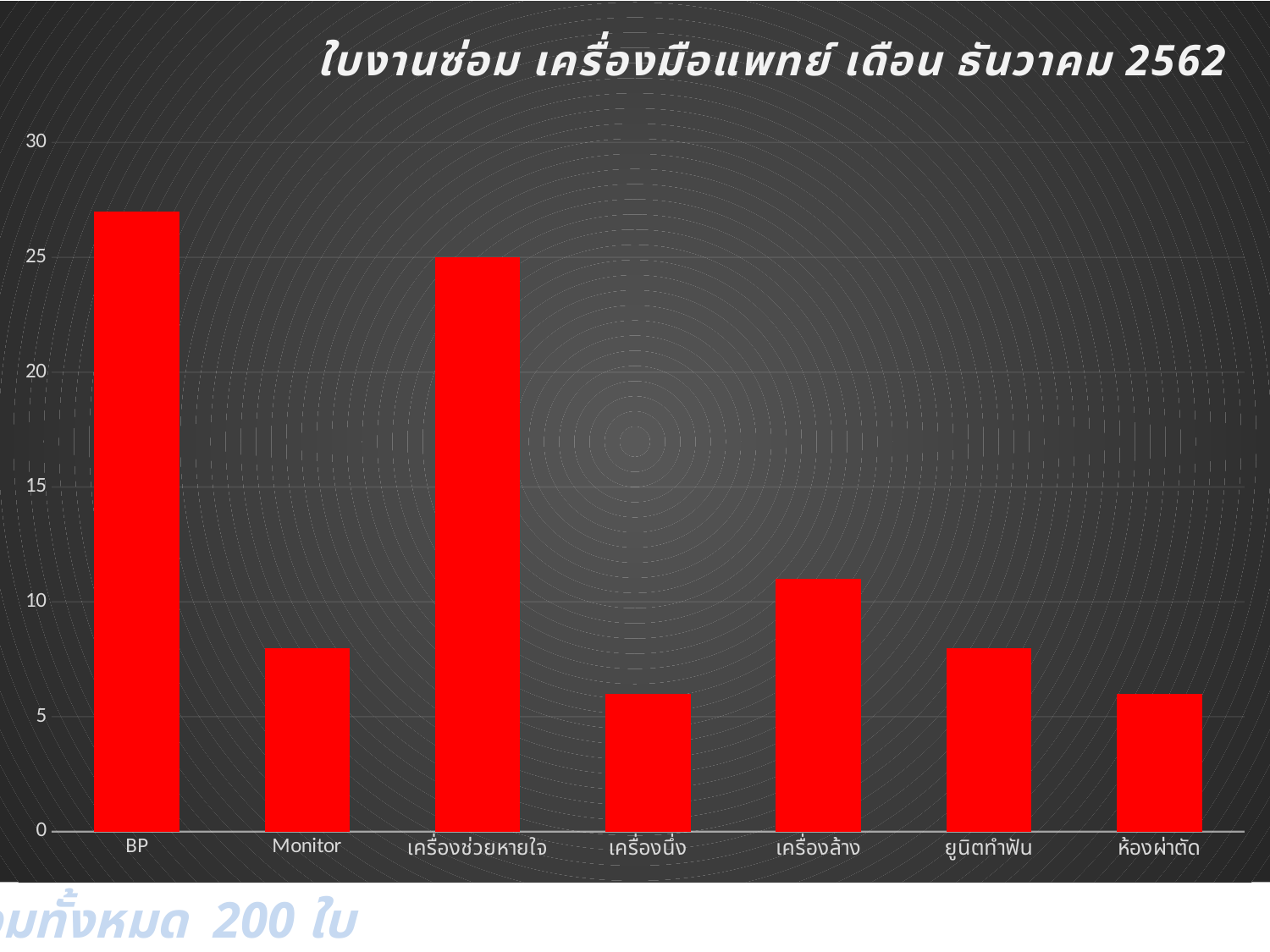
What colour are the bars in the chart? Red Is the value for Monitor greater or less than 10? less Which is larger, the value for เครื่องล้าง or the value for เครื่องนึ่ง? เครื่องล้าง What is the title of the chart? ใบงานซ่อม เครื่องมือแพทย์ เดือน ธันวาคม 2562 Is the value for เครื่องล้าง greater or less than 10? greater How many categories are shown on the x axis of the chart? 7 Which is larger, the value for BP or the value for Monitor? BP Is the value for BP greater or less than 25? greater What type of chart is shown on the slide? Bar chart Which category has the highest bar in the chart? BP What is the value for เครื่องช่วยหายใจ? 25